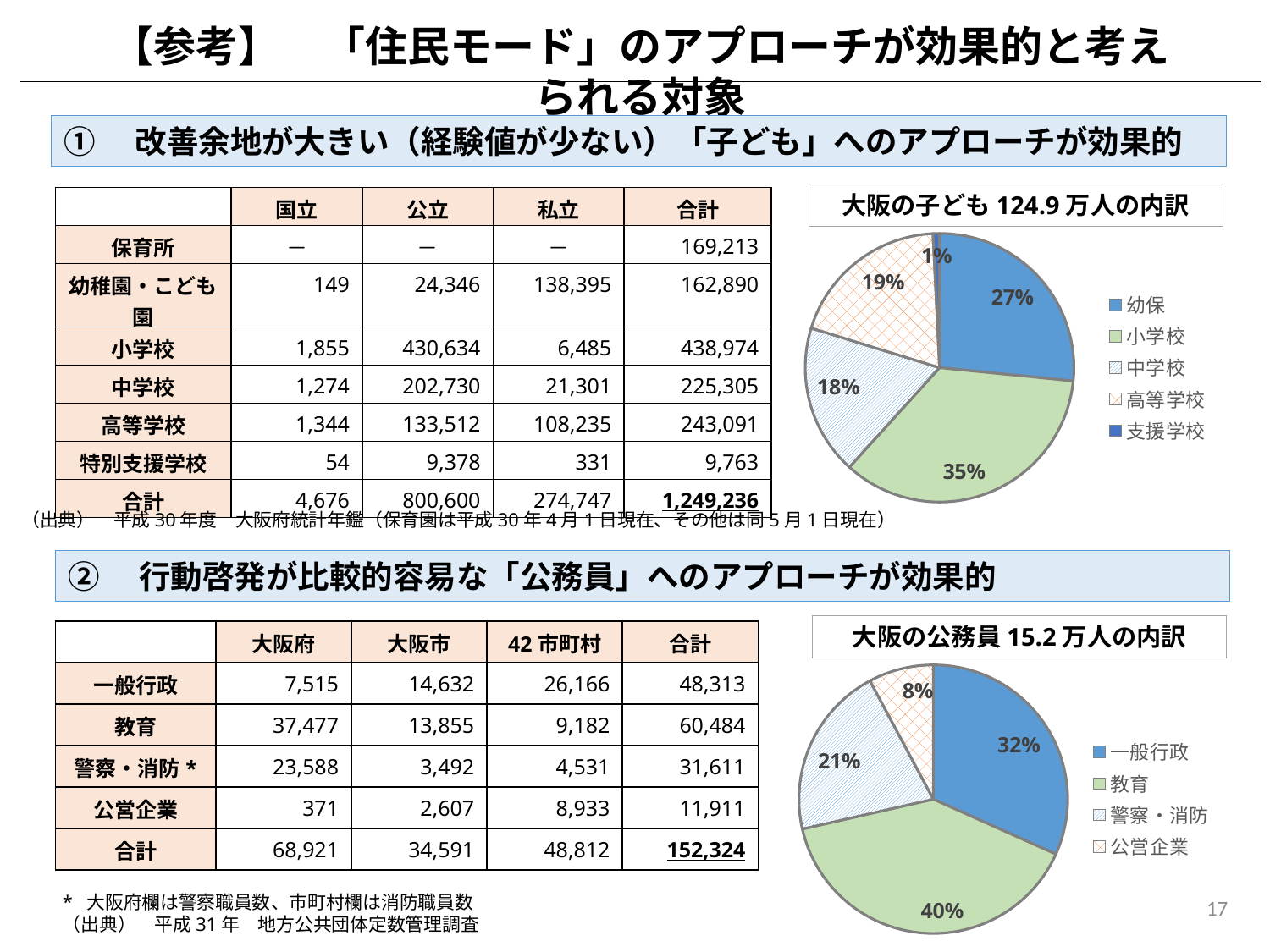
In the chart titled 大阪の子ども 124.9 万人の内訳, what is the difference in percentage points between 小学校 and 中学校? 17 In the chart titled 大阪の公務員 15.2 万人の内訳, how many slices does the pie have? 4 In the chart titled 大阪の公務員 15.2 万人の内訳, what is the difference in percentage points between 教育 and 一般行政? 8 In the chart titled 大阪の子ども 124.9 万人の内訳, what share does 小学校 have? 35% What kind of chart is the one titled 大阪の公務員 15.2 万人の内訳? pie chart In the chart titled 大阪の公務員 15.2 万人の内訳, what share does 教育 have? 40% In the chart titled 大阪の公務員 15.2 万人の内訳, which is larger, 一般行政 or 警察・消防? 一般行政 In the chart titled 大阪の子ども 124.9 万人の内訳, how many categories does the legend list? 5 In the chart titled 大阪の子ども 124.9 万人の内訳, which category has the largest share? 小学校 In the chart titled 大阪の公務員 15.2 万人の内訳, what share does 公営企業 have? 8% In the chart titled 大阪の子ども 124.9 万人の内訳, which category has the smallest share? 支援学校 In the chart titled 大阪の子ども 124.9 万人の内訳, what share does 幼保 have? 27%